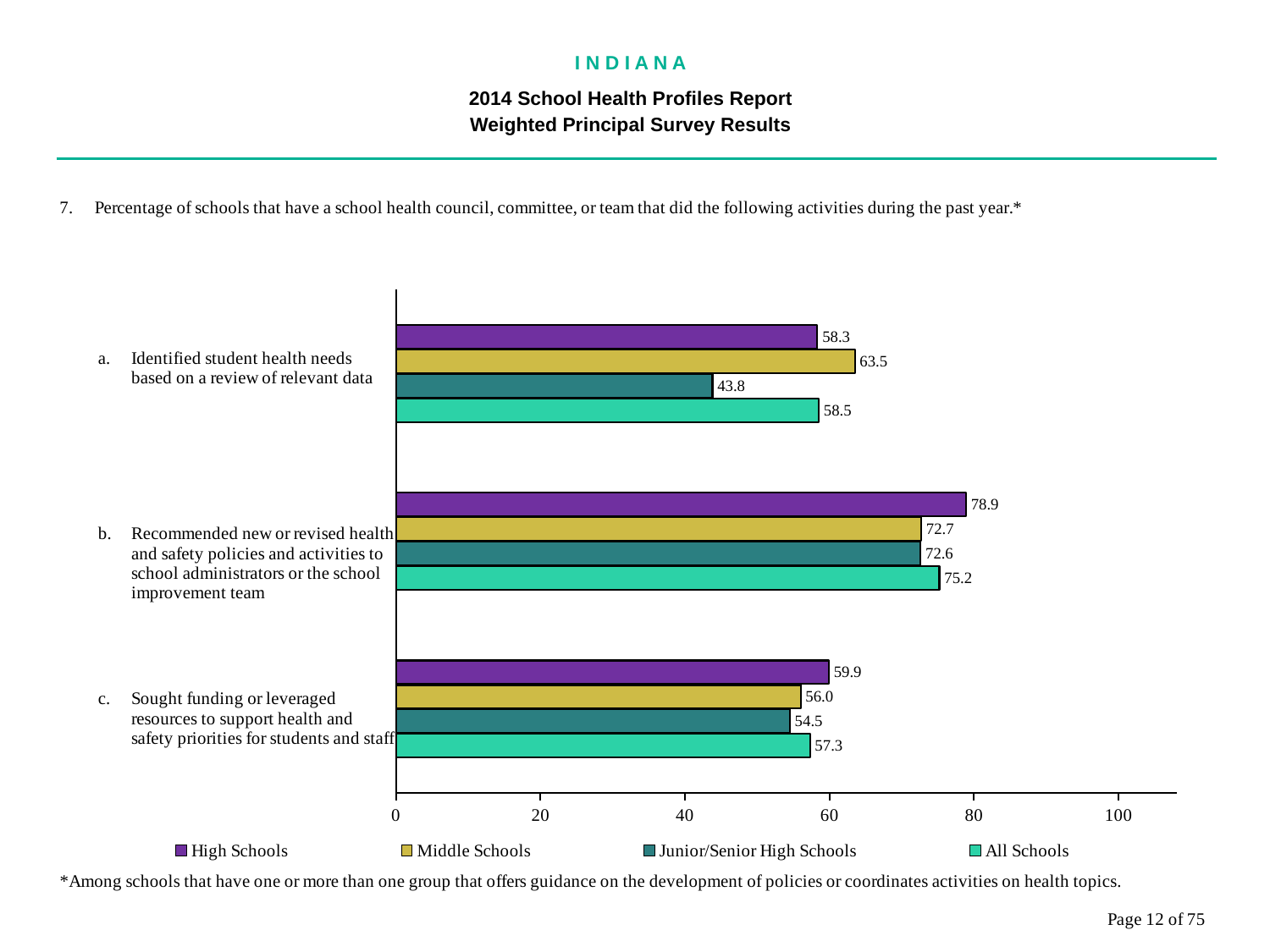
Which legend entry is shown in purple? High Schools Which school type has the lowest value for activity c (sought funding or leveraged resources)? Junior/Senior High Schools What is the value for All Schools for activity c (sought funding or leveraged resources)? 57.3 Which school type has the highest value for activity a (identified student health needs)? Middle Schools Is the Junior/Senior High Schools value for activity a greater or less than 60? less For activity c, which is larger: the High Schools value or the Middle Schools value? High Schools What is the value for High Schools for activity b (recommended new or revised health and safety policies)? 78.9 How many series does the legend list? 4 What is the difference between the High Schools and Junior/Senior High Schools values for activity b? 6.3 What kind of chart is shown on the slide? bar chart What is the value for Junior/Senior High Schools for activity a (identified student health needs based on a review of relevant data)? 43.8 How many activities (categories) are shown on the chart? 3